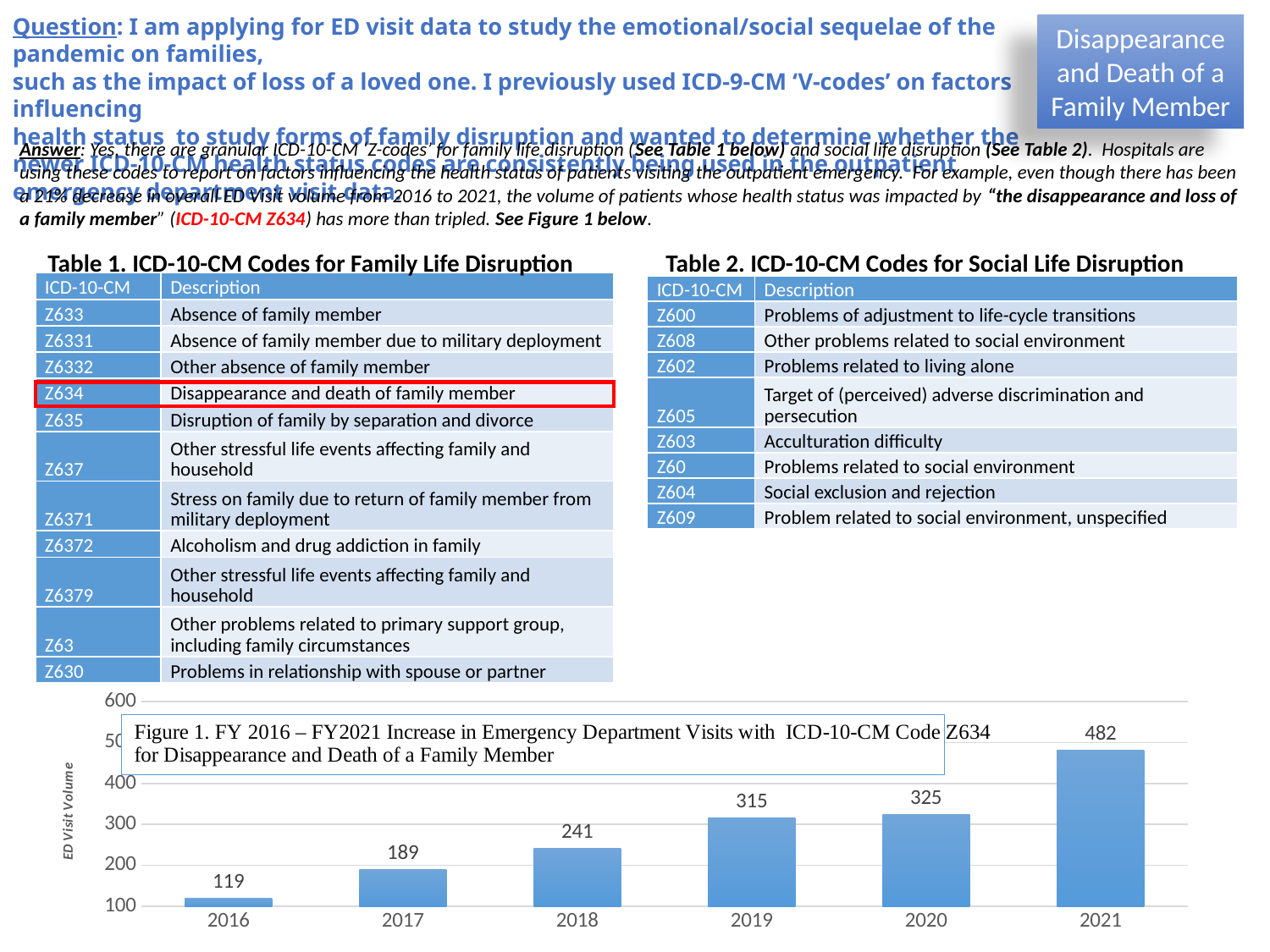
Is the ED visit volume for 2021 in Figure 1 greater or less than 400? greater Do the ED visit volumes in Figure 1 rise or fall from 2016 to 2021? rise What is the difference in ED visit volume between 2021 and 2016 in Figure 1? 363 What is the difference in ED visit volume between 2018 and 2017 in Figure 1? 52 What kind of chart is Figure 1? bar chart What is the ED visit volume for 2019 in Figure 1? 315 What is the ED visit volume for 2016 in Figure 1? 119 Which year has the highest ED visit volume in Figure 1? 2021 Which year has a larger ED visit volume in Figure 1, 2017 or 2020? 2020 Which year has the lowest ED visit volume in Figure 1? 2016 How many years are shown on the x axis of Figure 1? 6 What is the ED visit volume for 2021 in Figure 1? 482